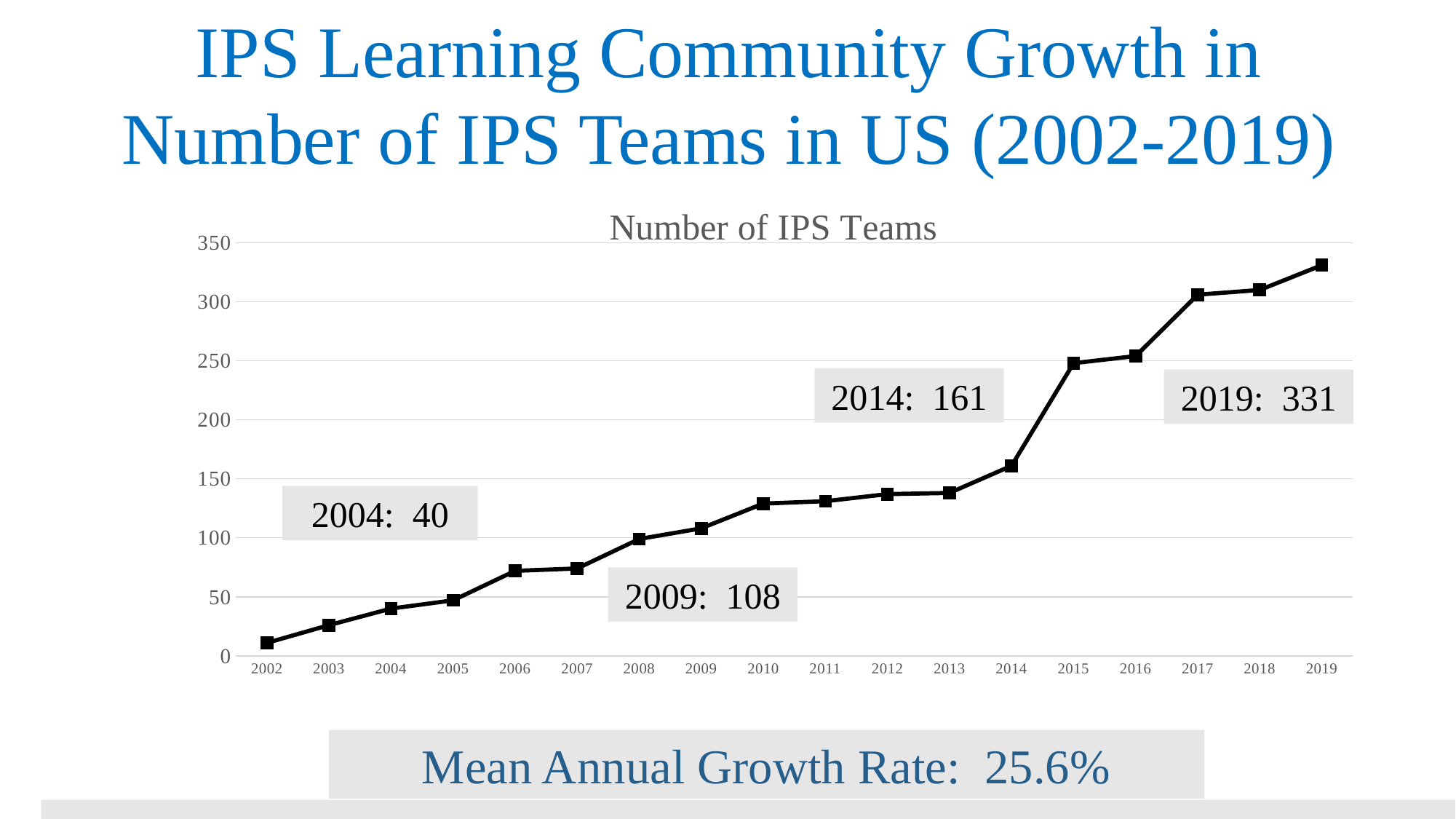
What is the number of IPS teams in 2004? 40 What is the number of IPS teams in 2014? 161 Which year has the lowest number of IPS teams? 2002 How many years are plotted on the x axis of the chart? 18 What is the number of IPS teams in 2019? 331 What is the number of IPS teams in 2009? 108 Is the number of IPS teams in 2012 greater or less than 150? less What is the difference in the number of IPS teams between 2009 and 2004? 68 Does the number of IPS teams generally rise or fall from 2002 to 2019? rise What kind of chart is shown on the slide? line chart Which year has the highest number of IPS teams? 2019 By how much did the number of IPS teams increase from 2014 to 2019? 170